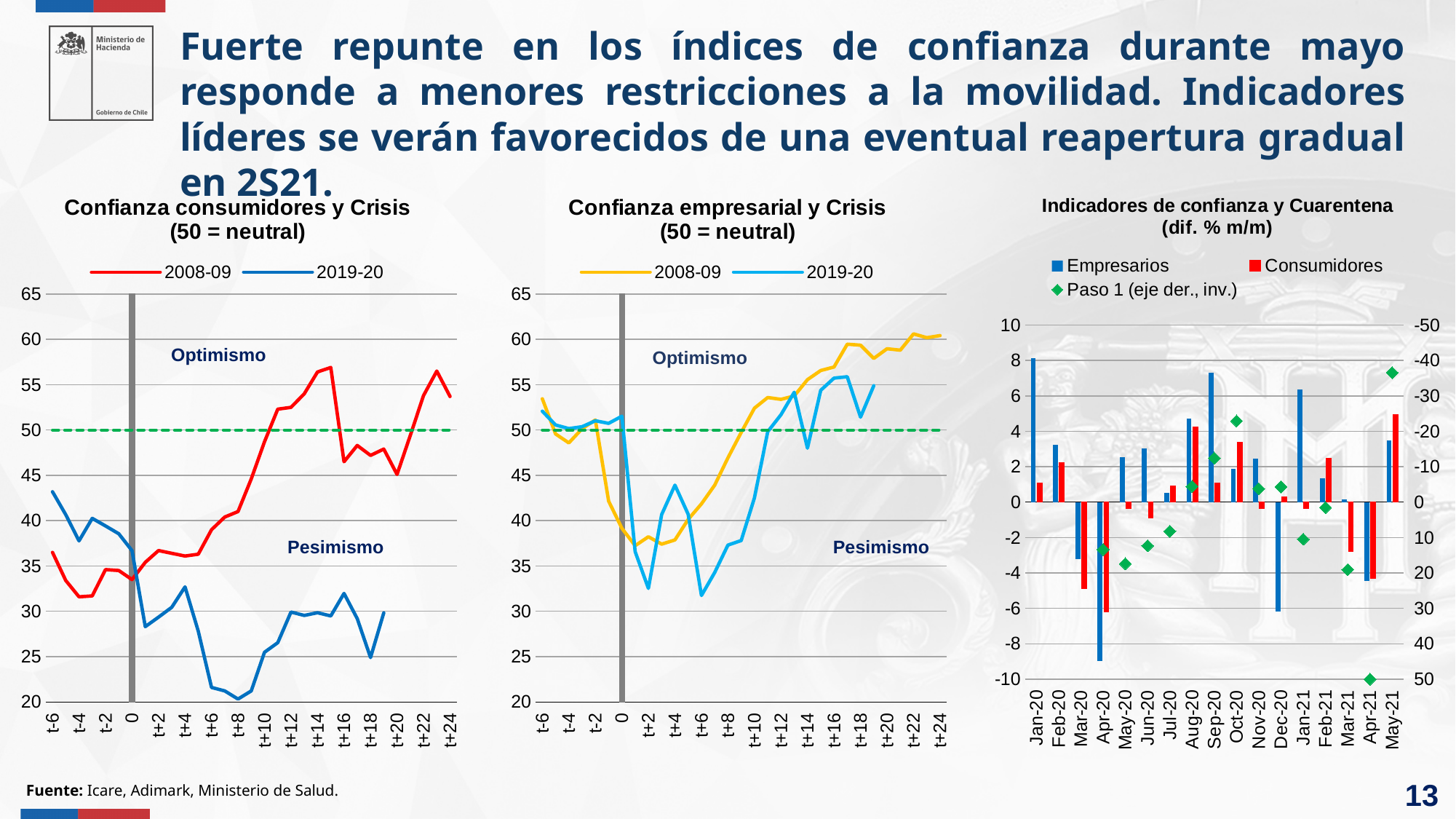
In 'Indicadores de confianza y Cuarentena', is the Empresarios value for Apr-20 greater or less than -8? less In 'Confianza consumidores y Crisis', is the 2008-09 value at t+14 greater or less than 55? greater In 'Indicadores de confianza y Cuarentena', which month has the lowest Empresarios value? Apr-20 In 'Confianza consumidores y Crisis', is the 2019-20 value at t+8 greater or less than 25? less In 'Confianza empresarial y Crisis', does the 2008-09 line rise or fall from t+10 to t+24? rise How many months are shown on the x axis of 'Indicadores de confianza y Cuarentena'? 17 How many entries does the legend of 'Indicadores de confianza y Cuarentena (dif. % m/m)' list? 3 In 'Indicadores de confianza y Cuarentena', which is larger for Jan-20: Empresarios or Consumidores? Empresarios How many series does the legend of 'Confianza empresarial y Crisis (50 = neutral)' list? 2 What kind of chart is 'Confianza consumidores y Crisis (50 = neutral)'? line chart